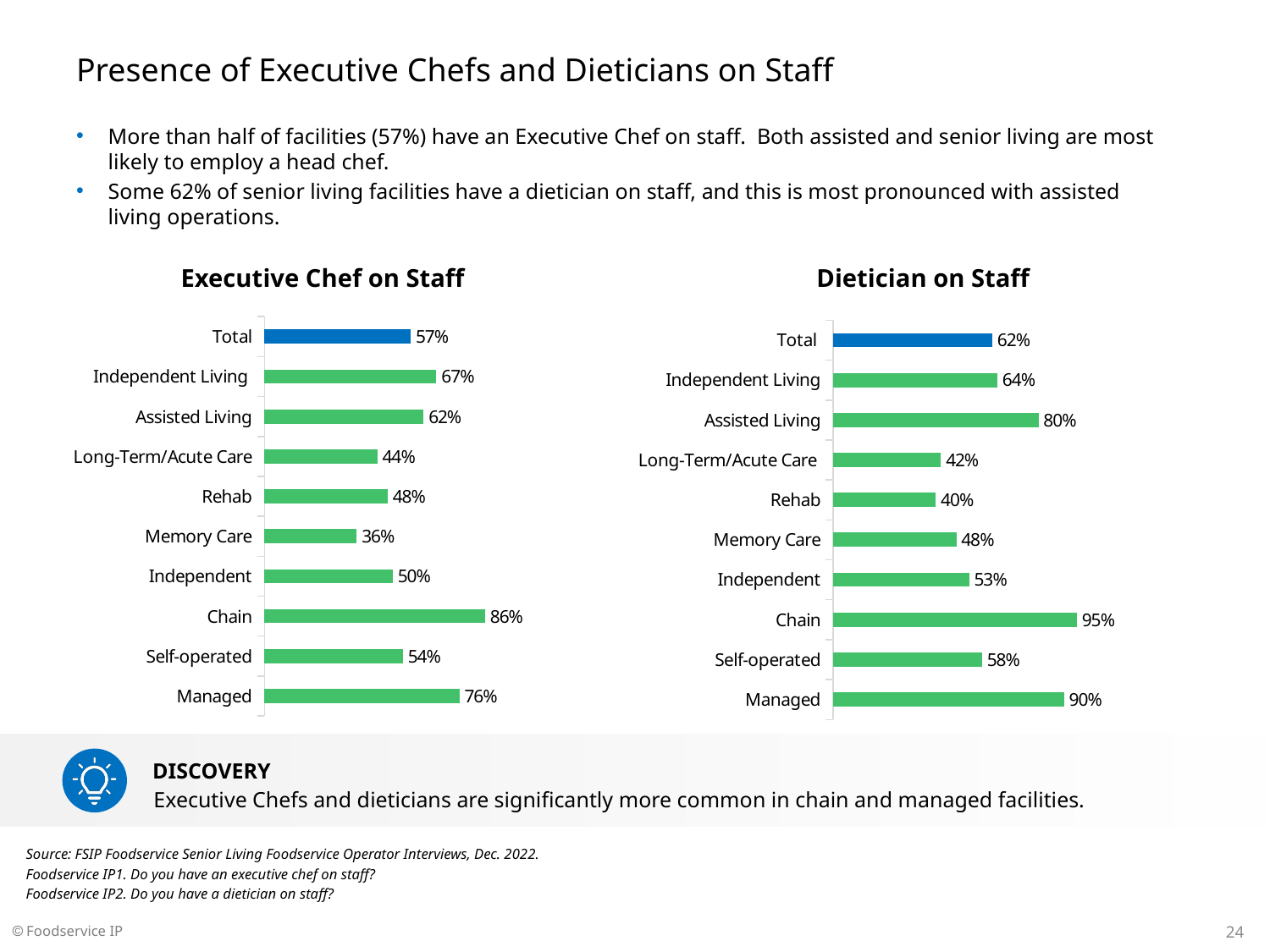
How many categories are shown in the 'Executive Chef on Staff' chart? 10 In the 'Dietician on Staff' chart, which is larger, the value for Memory Care or the value for Long-Term/Acute Care? Memory Care In the 'Executive Chef on Staff' chart, which is larger, the value for Independent Living or the value for Assisted Living? Independent Living In the 'Dietician on Staff' chart, which category has the highest value? Chain In the 'Dietician on Staff' chart, what is the difference between the values for Managed and Self-operated? 32% In the 'Dietician on Staff' chart, which category has the lowest value? Rehab In the 'Executive Chef on Staff' chart, what is the difference between the values for Chain and Self-operated? 32% In the 'Executive Chef on Staff' chart, which category has the lowest value? Memory Care What kind of chart is the 'Dietician on Staff' chart? Bar chart In the 'Executive Chef on Staff' chart, what is the value for Total? 57% In the 'Dietician on Staff' chart, what is the value for Assisted Living? 80% In the 'Executive Chef on Staff' chart, what is the value for Chain? 86%